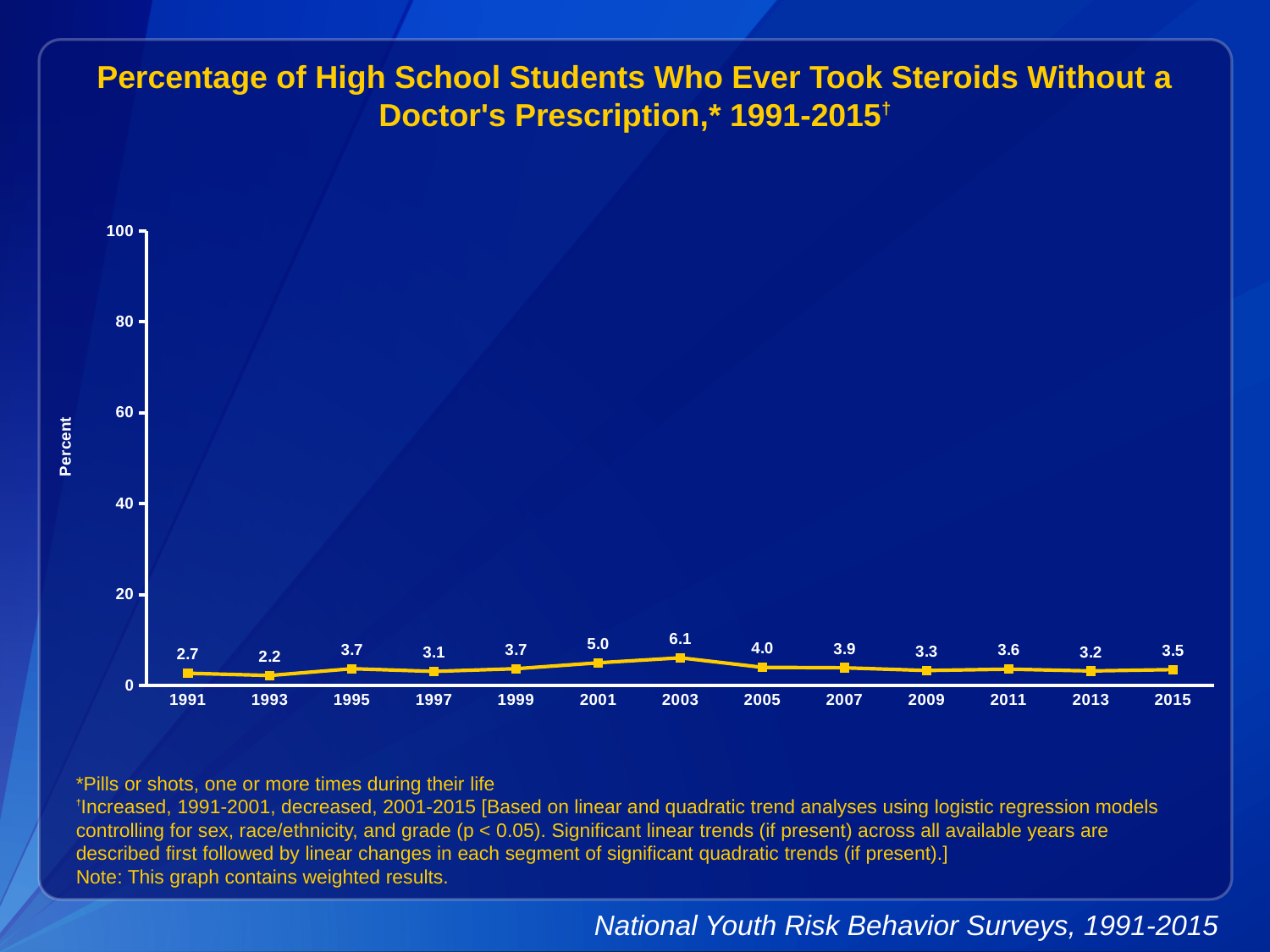
What is the value for 1991? 2.7 Is the value for 2003 greater or less than 20? less Which year has the lowest value? 1993 Do the values rise or fall from 2003 to 2009? fall Which is larger, the value for 2001 or the value for 2005? 2001 What is the difference between the values for 2003 and 1993? 3.9 Which year has the highest value? 2003 What is the label on the y axis? Percent What is the value for 2003? 6.1 How many years are plotted on the chart? 13 What is the value for 2015? 3.5 What kind of chart is shown? line chart